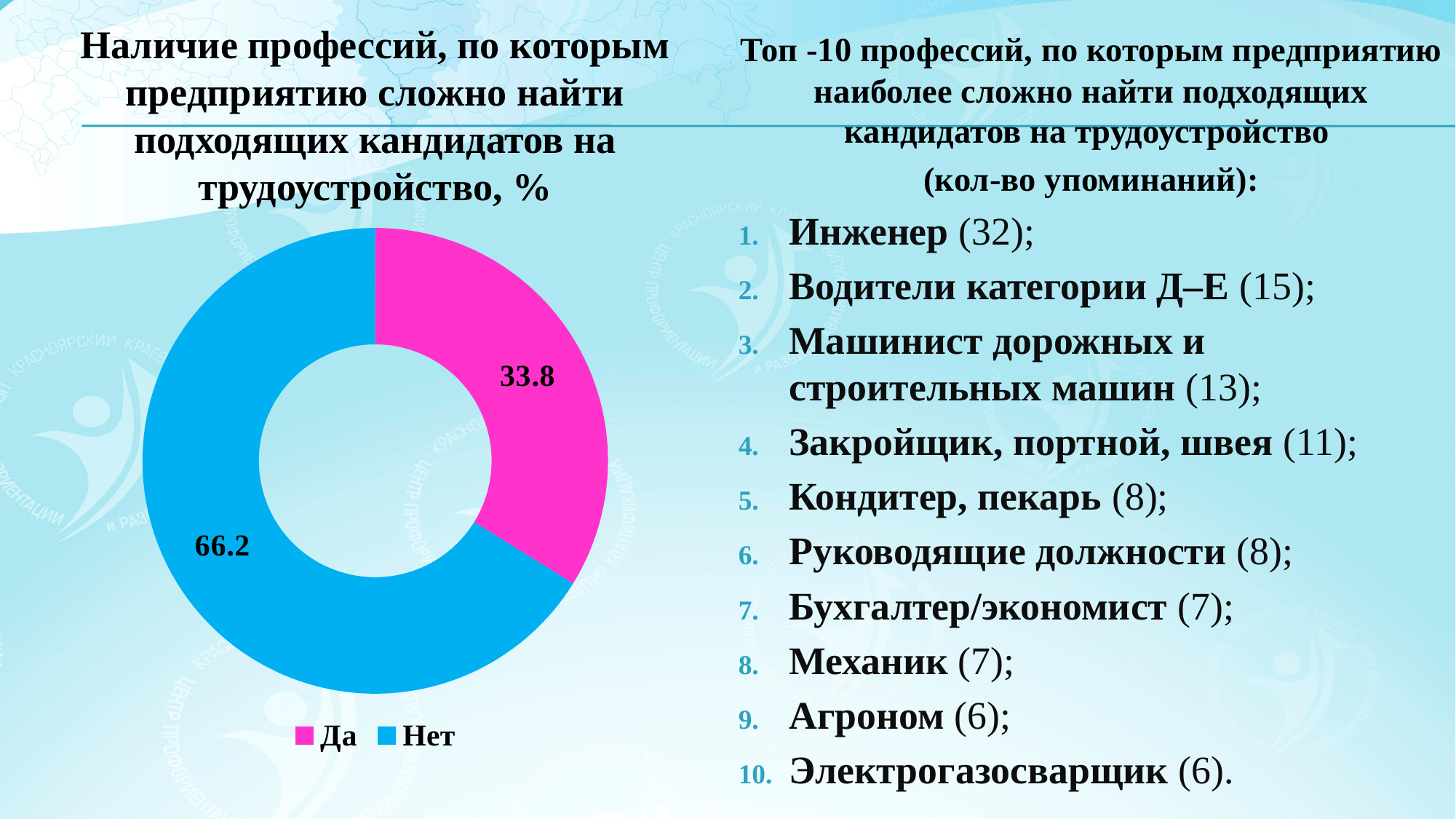
How many categories does the chart show? 2 How many entries does the chart legend list? 2 Which is larger, the value for "Да" or the value for "Нет"? Нет What type of chart is shown on the slide? Doughnut chart What colour is the "Нет" slice in the chart? Blue Which category has the largest share in the chart? Нет What colour is the "Да" slice in the chart? Pink (magenta) Which category has the smallest share in the chart? Да What is the difference between the values for "Нет" and "Да"? 32.4 What is the value for "Да" in the chart? 33.8 What is the value for "Нет" in the chart? 66.2